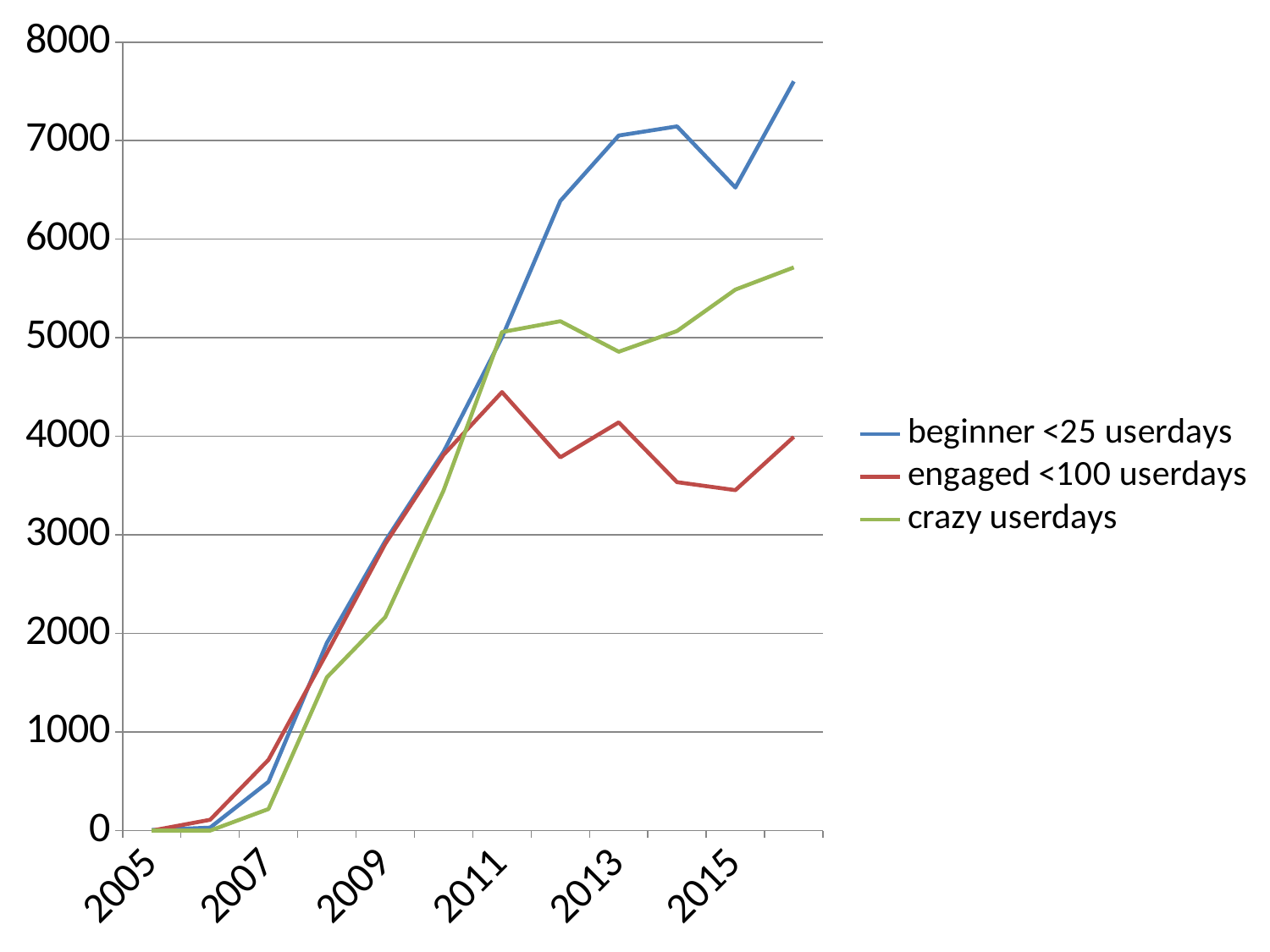
What colour is the line for crazy userdays? green Is the value for engaged <100 userdays in 2011 greater or less than 4000? greater How many series does the legend list? 3 Which series is lowest in 2016? engaged <100 userdays Is the value for beginner <25 userdays in 2016 greater or less than 7000? greater Does the beginner <25 userdays line rise or fall from 2005 to 2011? rise What kind of chart is shown on the slide? line chart In 2013, which is larger: engaged <100 userdays or crazy userdays? crazy userdays Which series is highest in 2016? beginner <25 userdays In 2016, which is larger: beginner <25 userdays or crazy userdays? beginner <25 userdays Is the value for crazy userdays in 2013 greater or less than 5000? less